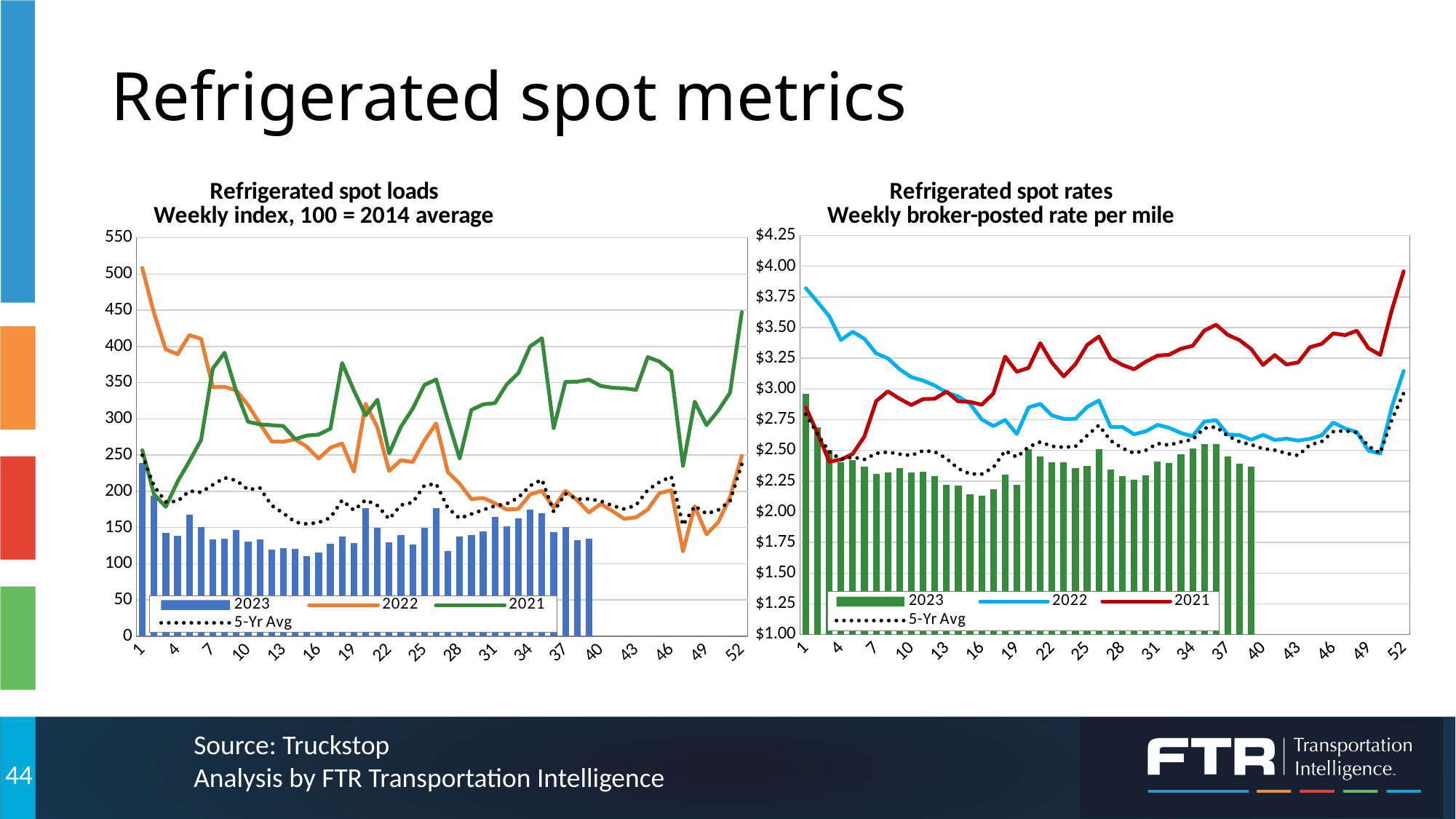
In the Refrigerated spot loads chart, is the 2021 value at week 52 greater or less than 400? greater In the Refrigerated spot loads chart, how many series does the legend list? 4 In the Refrigerated spot rates chart, is the 2022 value at week 1 greater or less than $3.50? greater In the Refrigerated spot rates chart, is the 2023 value at week 16 greater or less than $2.25? less In the Refrigerated spot rates chart, does the 2021 line overall rise or fall from week 1 to week 52? rise In the Refrigerated spot loads chart, at week 1, which is larger: the 2022 value or the 2021 value? 2022 In the Refrigerated spot rates chart, at week 52, which is larger: the 2021 value or the 2022 value? 2021 In the Refrigerated spot rates chart, how many series does the legend list? 4